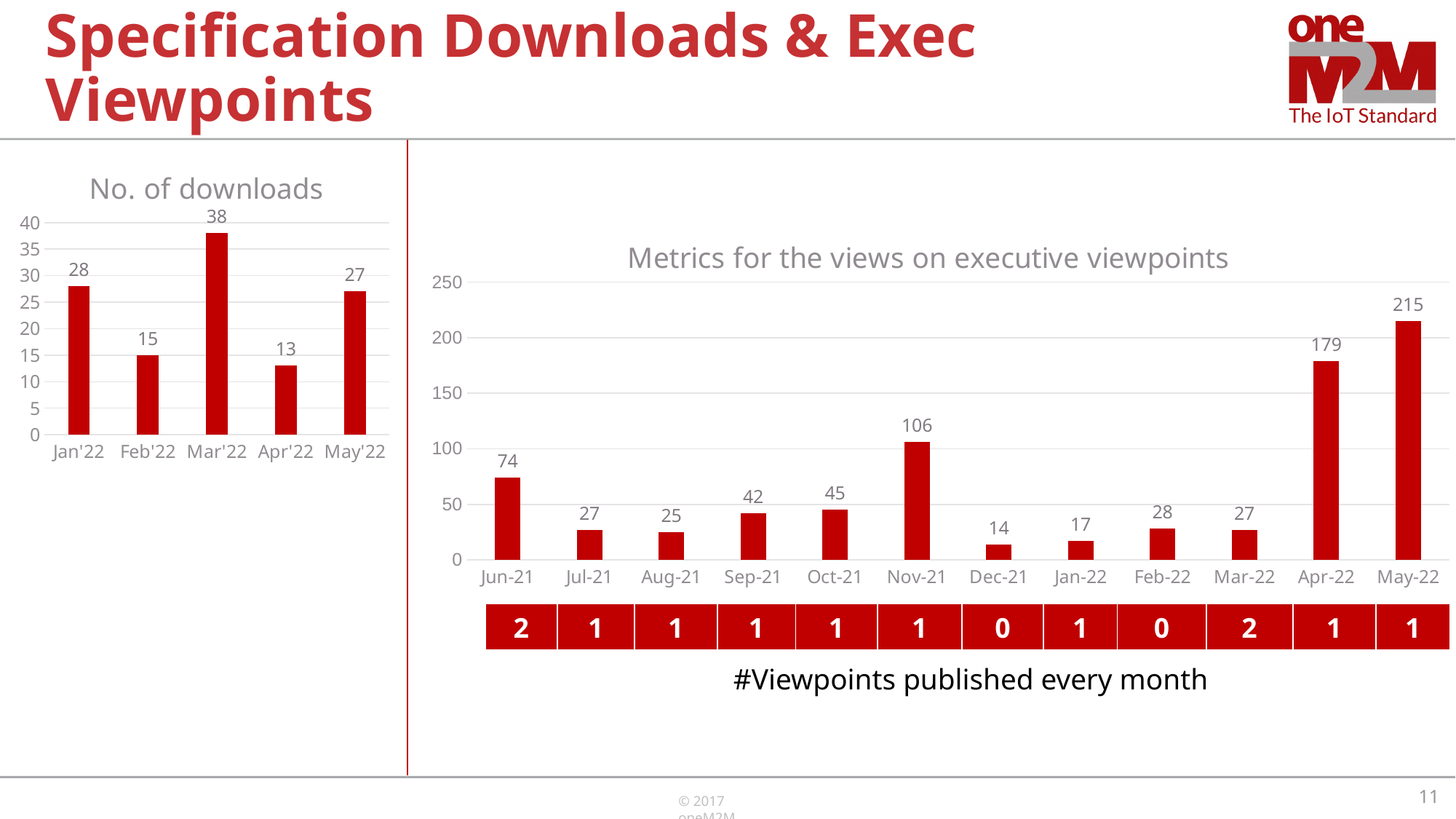
In the 'Metrics for the views on executive viewpoints' chart, is the value for Apr-22 greater or less than 150? greater In the 'Metrics for the views on executive viewpoints' chart, what is the difference between the values for May-22 and Apr-22? 36 In the 'No. of downloads' chart, what is the difference between the values for Jan'22 and Feb'22? 13 In the 'Metrics for the views on executive viewpoints' chart, which month has the lowest value? Dec-21 In the 'No. of downloads' chart, how many months are shown on the x axis? 5 What kind of chart is the 'Metrics for the views on executive viewpoints' chart? Bar chart In the 'Metrics for the views on executive viewpoints' chart, how many months are shown on the x axis? 12 In the 'No. of downloads' chart, what is the value for Mar'22? 38 In the 'Metrics for the views on executive viewpoints' chart, what is the value for Nov-21? 106 In the 'Metrics for the views on executive viewpoints' chart, which is larger, the value for Sep-21 or the value for Oct-21? Oct-21 In the 'No. of downloads' chart, which month has the lowest number of downloads? Apr'22 In the 'Metrics for the views on executive viewpoints' chart, which month has the highest value? May-22